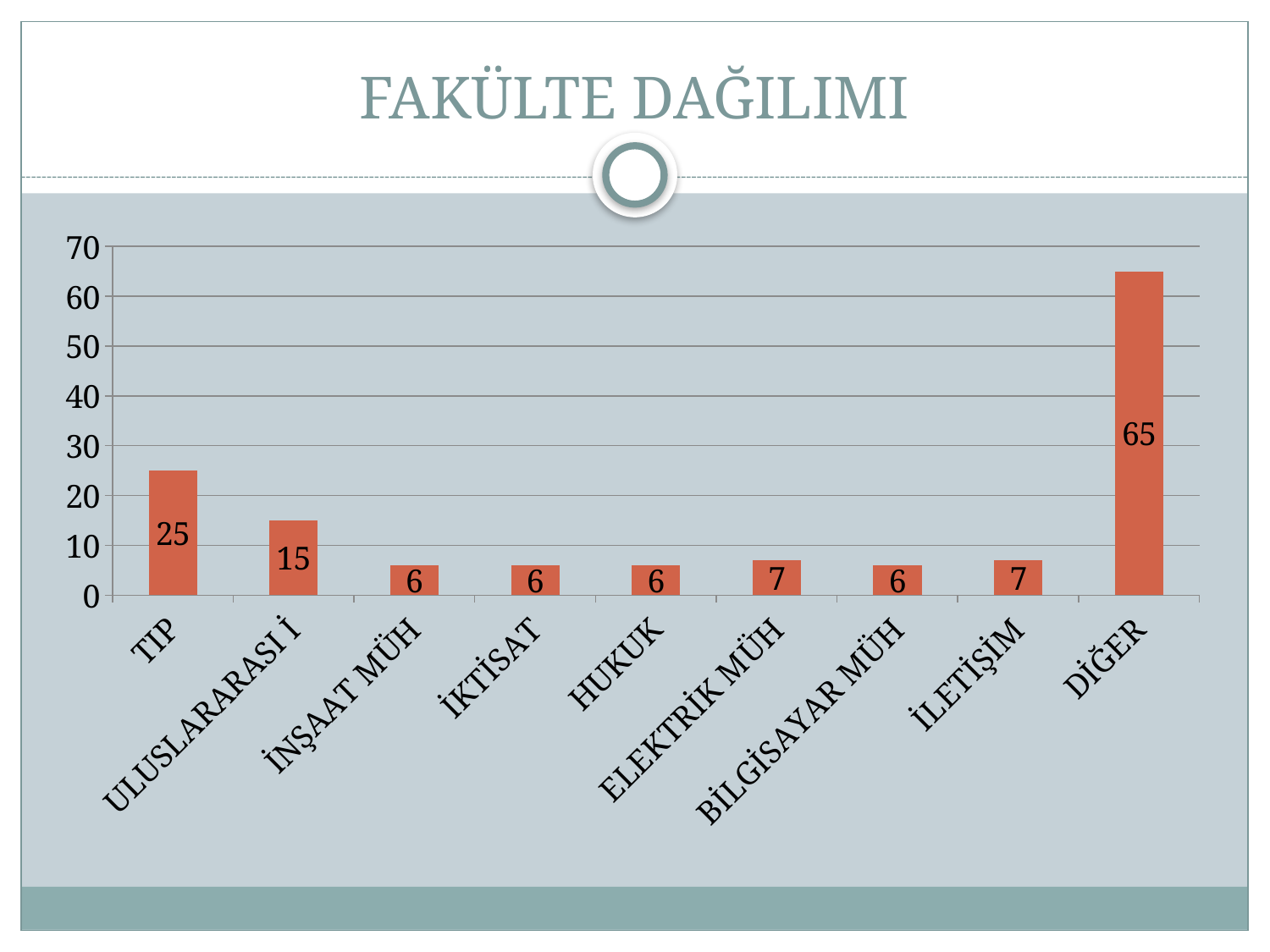
What is the difference between the values for DİĞER and TIP? 40 How many categories are shown on the x axis? 9 What kind of chart is shown on the slide? bar chart What is the value for ELEKTRİK MÜH? 7 What is the value for ULUSLARARASI İ? 15 Which is larger, the value for TIP or the value for ULUSLARARASI İ? TIP What is the value for HUKUK? 6 What is the difference between the values for TIP and ULUSLARARASI İ? 10 Which category has the highest value? DİĞER What is the title of the slide? FAKÜLTE DAĞILIMI Is the value for DİĞER greater or less than 60? greater What is the value for TIP? 25